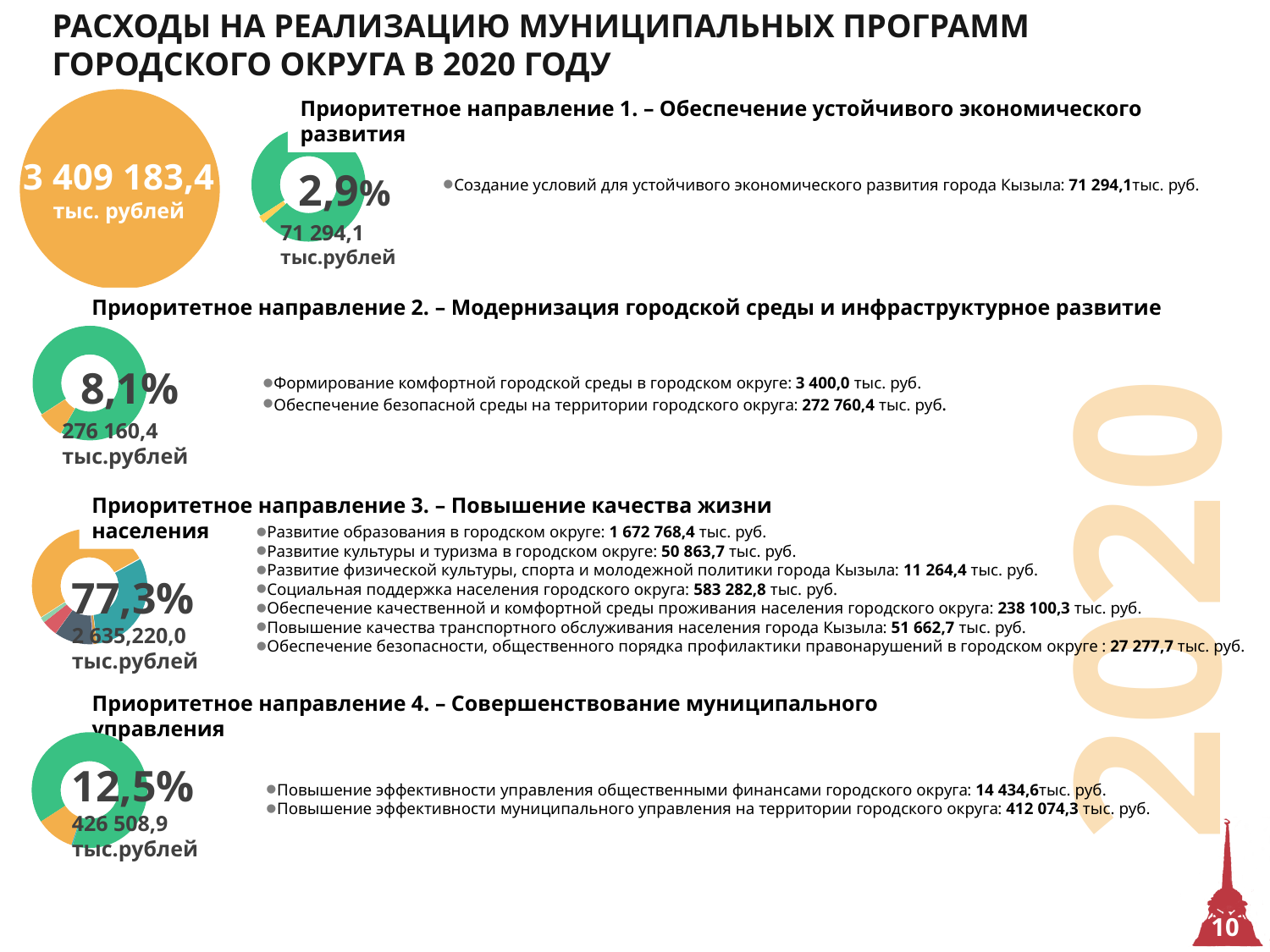
Which priority direction has the smallest share according to the donut charts? Приоритетное направление 1 (2,9%) In the donut chart for Приоритетное направление 4, what percentage is shown? 12,5% What kind of chart is used to show the share of each priority direction on the slide? Donut (pie) chart In the donut chart for Приоритетное направление 2, what percentage is shown? 8,1% Which share is larger: Приоритетное направление 2 or Приоритетное направление 4? Приоритетное направление 4 In the donut chart for Приоритетное направление 3, what percentage is shown? 77,3% What is the difference in percentage points between the share of Приоритетное направление 4 and Приоритетное направление 2? 4,4 What amount in тыс. рублей is shown under the donut chart for Приоритетное направление 4? 426 508,9 тыс.рублей How many donut charts are shown on the slide? 4 Which priority direction has the largest share according to the donut charts? Приоритетное направление 3 (77,3%) What amount in тыс. рублей is shown under the donut chart for Приоритетное направление 2? 276 160,4 тыс.рублей In the donut chart for Приоритетное направление 1, what percentage is shown? 2,9%